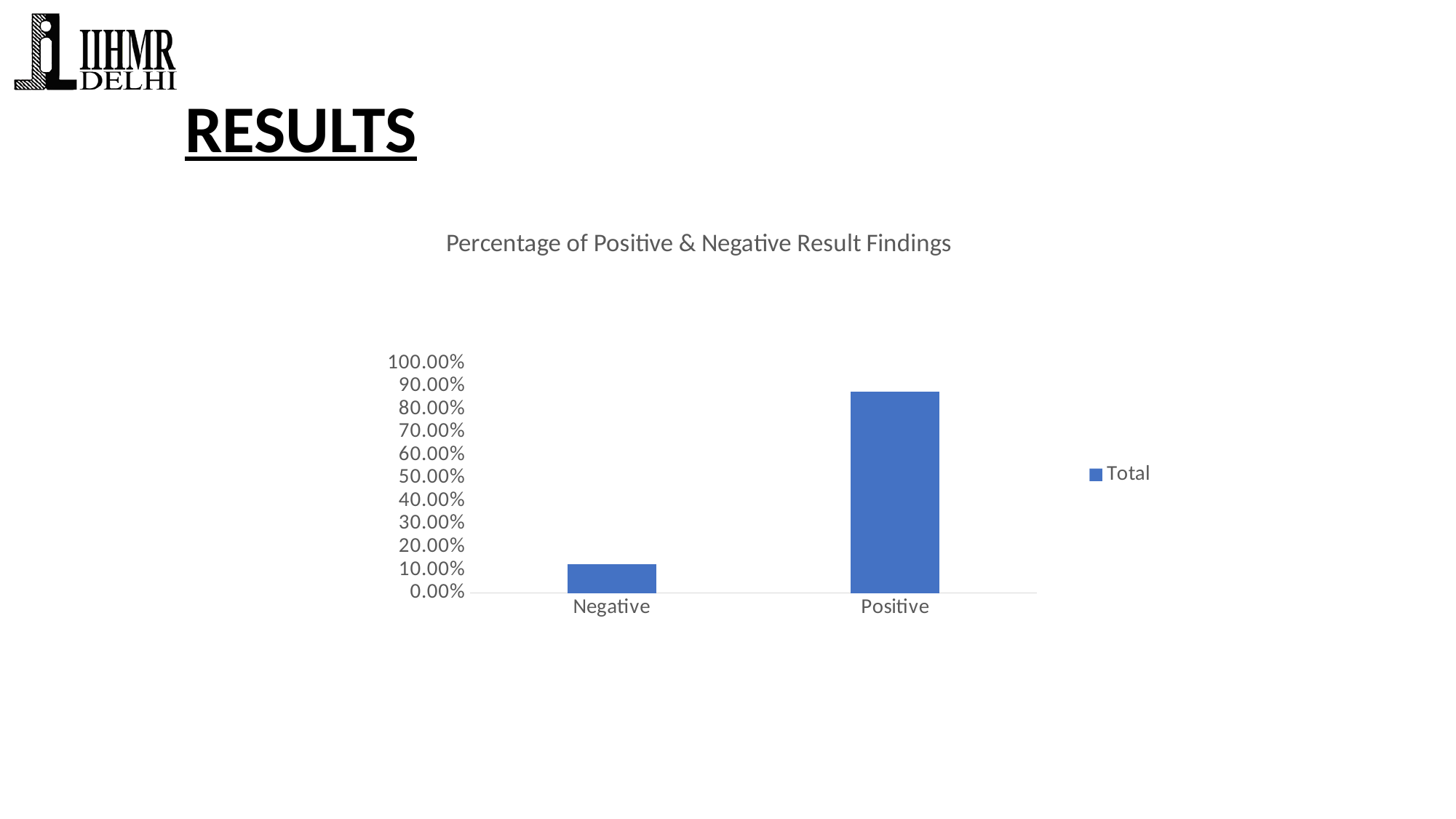
Is the value for Negative greater or less than 20.00%? less What is the title of the chart? Percentage of Positive & Negative Result Findings Do the values rise or fall from Negative to Positive along the x axis? rise Which category has the lowest value in the chart? Negative Is the value for Positive greater or less than 80.00%? greater Which is larger, the value for Positive or the value for Negative? Positive What type of chart is shown on the slide? bar chart How many series does the chart legend list? 1 What series name is shown in the chart legend? Total How many categories are shown on the x axis of the chart? 2 Is the value for Positive greater or less than 50.00%? greater Which category has the highest value in the chart? Positive